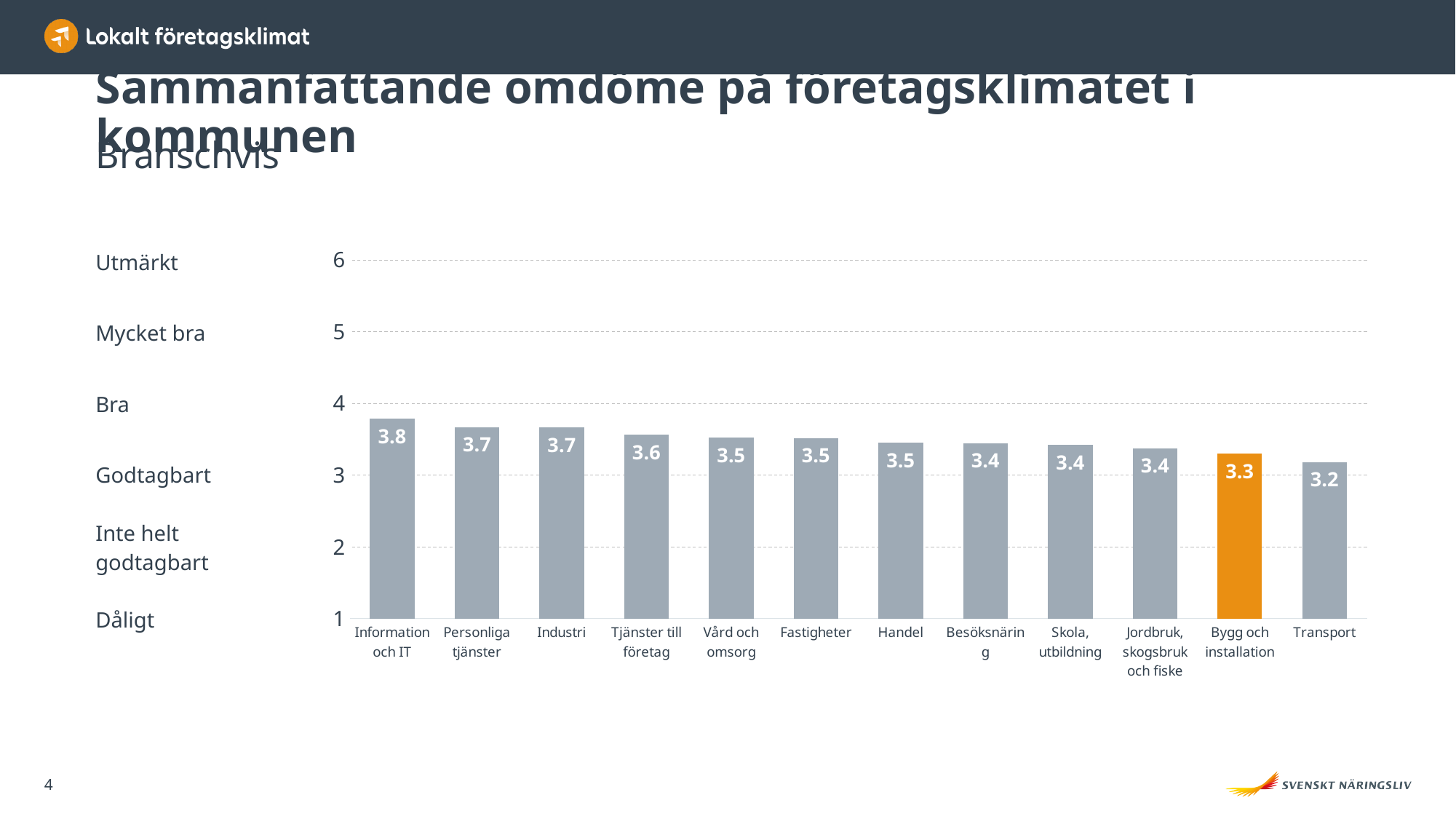
What kind of chart is shown on the slide? bar chart Which category has the lowest value? Transport How many categories are shown on the x axis? 12 Which is larger, the value for Industri or the value for Handel? Industri Is the value for Fastigheter greater or less than 4? less What is the value for Information och IT? 3.8 What is the value for Bygg och installation? 3.3 What is the difference between the values for Information och IT and Transport? 0.6 What is the value for Tjänster till företag? 3.6 Which category has the highest value? Information och IT Which category's bar is highlighted in orange? Bygg och installation What is the value for Transport? 3.2